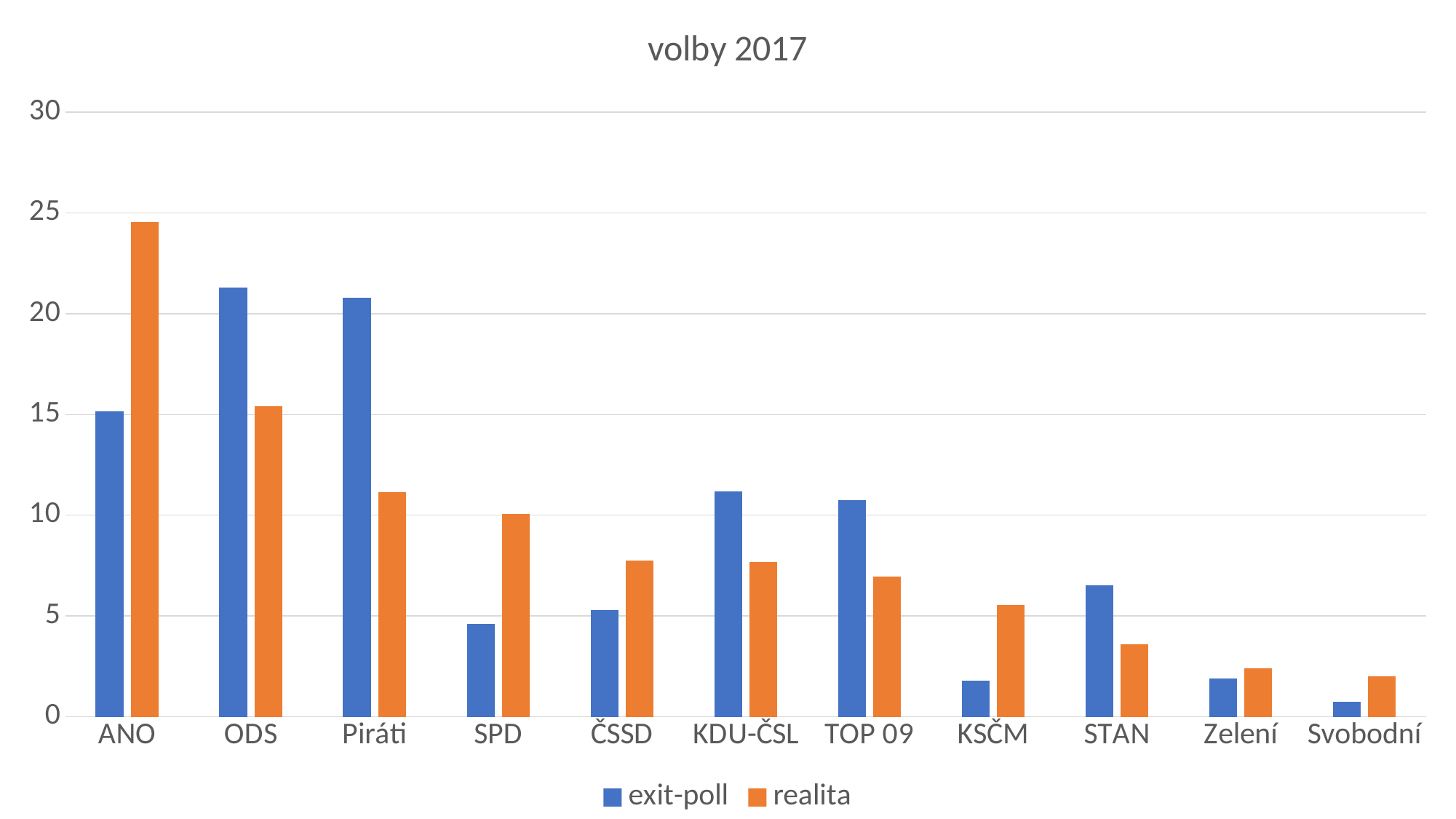
Is the realita value for ANO greater or less than 20? greater Is the exit-poll value for KDU-ČSL greater or less than 10? greater What kind of chart is shown on the slide? bar chart For ANO, which is larger: the exit-poll value or the realita value? realita How many series does the legend list? 2 Which colour represents the realita series in the legend? orange What is the title of the chart? volby 2017 For Piráti, which is larger: the exit-poll value or the realita value? exit-poll How many parties (categories) are shown on the x axis? 11 Which party has the highest realita value? ANO Is the exit-poll value for KSČM greater or less than 5? less Which party has the lowest exit-poll value? Svobodní